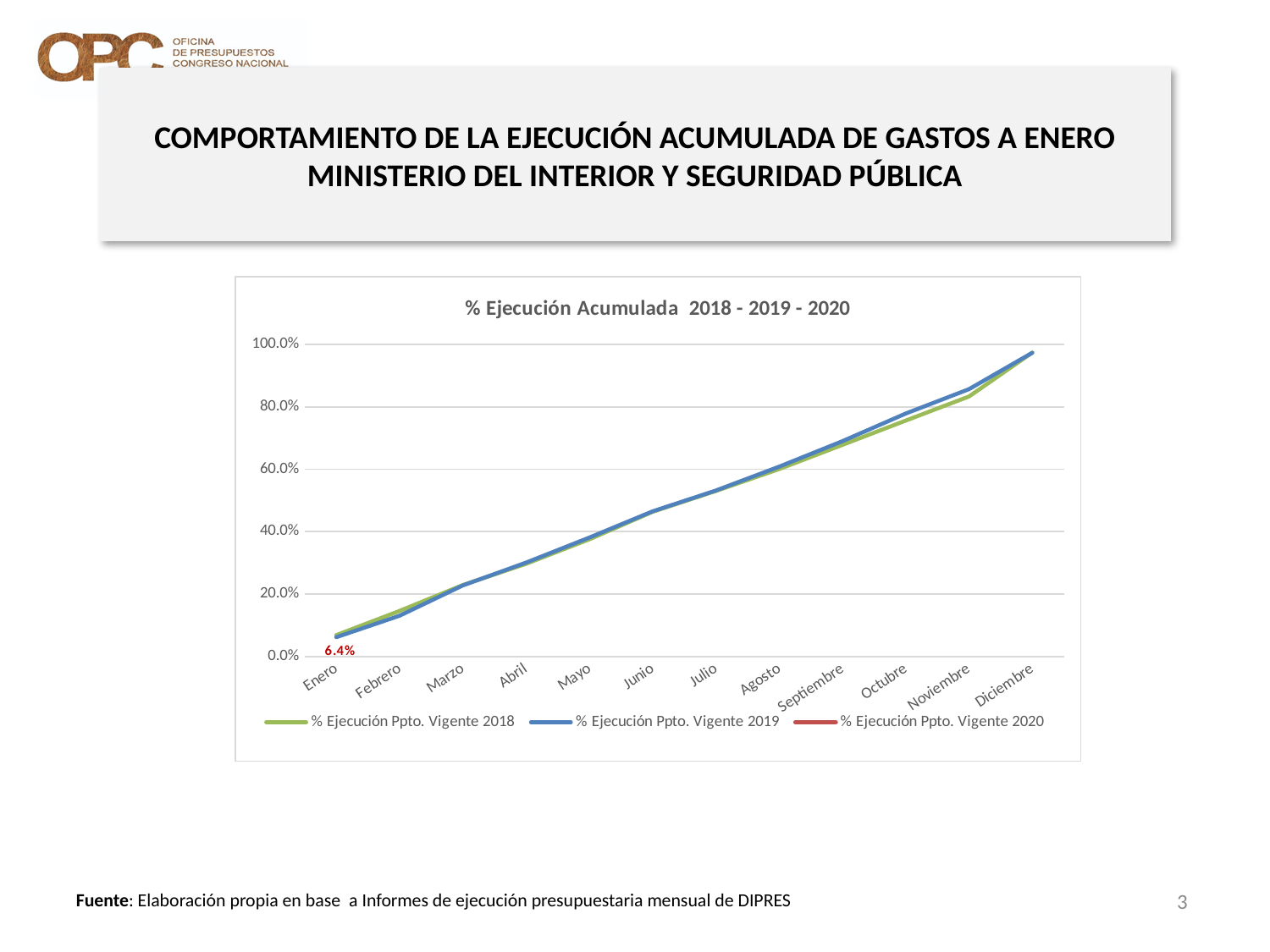
What is the title of the chart? % Ejecución Acumulada 2018 - 2019 - 2020 Do the values of % Ejecución Ppto. Vigente 2019 rise or fall from Enero to Diciembre? rise In which month does % Ejecución Ppto. Vigente 2018 have its lowest value? Enero Is the value of % Ejecución Ppto. Vigente 2019 for Diciembre greater or less than 80.0%? greater What is the value of % Ejecución Ppto. Vigente 2020 for Enero? 6.4% Is the value of % Ejecución Ppto. Vigente 2018 for Junio greater or less than 60.0%? less How many series does the legend of the chart list? 3 Is the value of % Ejecución Ppto. Vigente 2019 for Noviembre greater or less than 80.0%? greater What kind of chart is shown on the slide? line chart How many months are shown along the x axis of the chart? 12 In which month does % Ejecución Ppto. Vigente 2019 reach its highest value? Diciembre